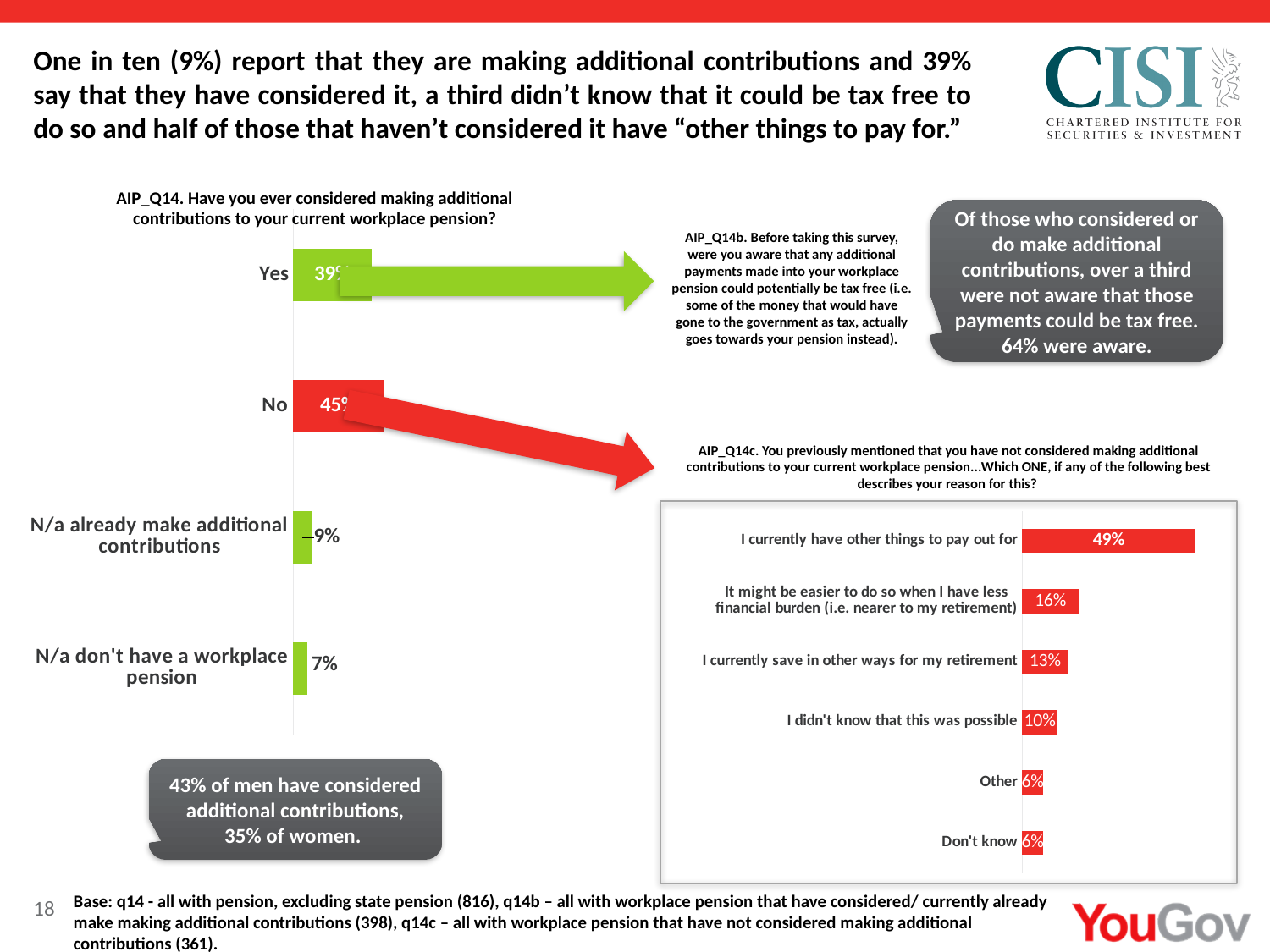
In the AIP_Q14 chart on the left, which response has the lowest value? N/a don't have a workplace pension In the AIP_Q14c chart on the right, how many reason categories are listed? 6 In the AIP_Q14 chart on the left, which response has the highest value? No What type of chart is the AIP_Q14c chart on the right? Bar chart In the AIP_Q14c chart on the right, what is the difference between "It might be easier to do so when I have less financial burden" and "I didn't know that this was possible"? 6% In the AIP_Q14 chart on the left, how many response categories are shown? 4 In the AIP_Q14c chart on the right, which reason has the highest percentage? I currently have other things to pay out for In the AIP_Q14 chart on the left, what percentage answered "No"? 45% In the AIP_Q14c chart on the right, what percentage chose "I currently have other things to pay out for"? 49% In the AIP_Q14 chart on the left, what is the difference between the "No" and "Yes" percentages? 6% In the AIP_Q14c chart on the right, what percentage chose "I currently save in other ways for my retirement"? 13% In the AIP_Q14 chart on the left, what percentage answered "N/a already make additional contributions"? 9%